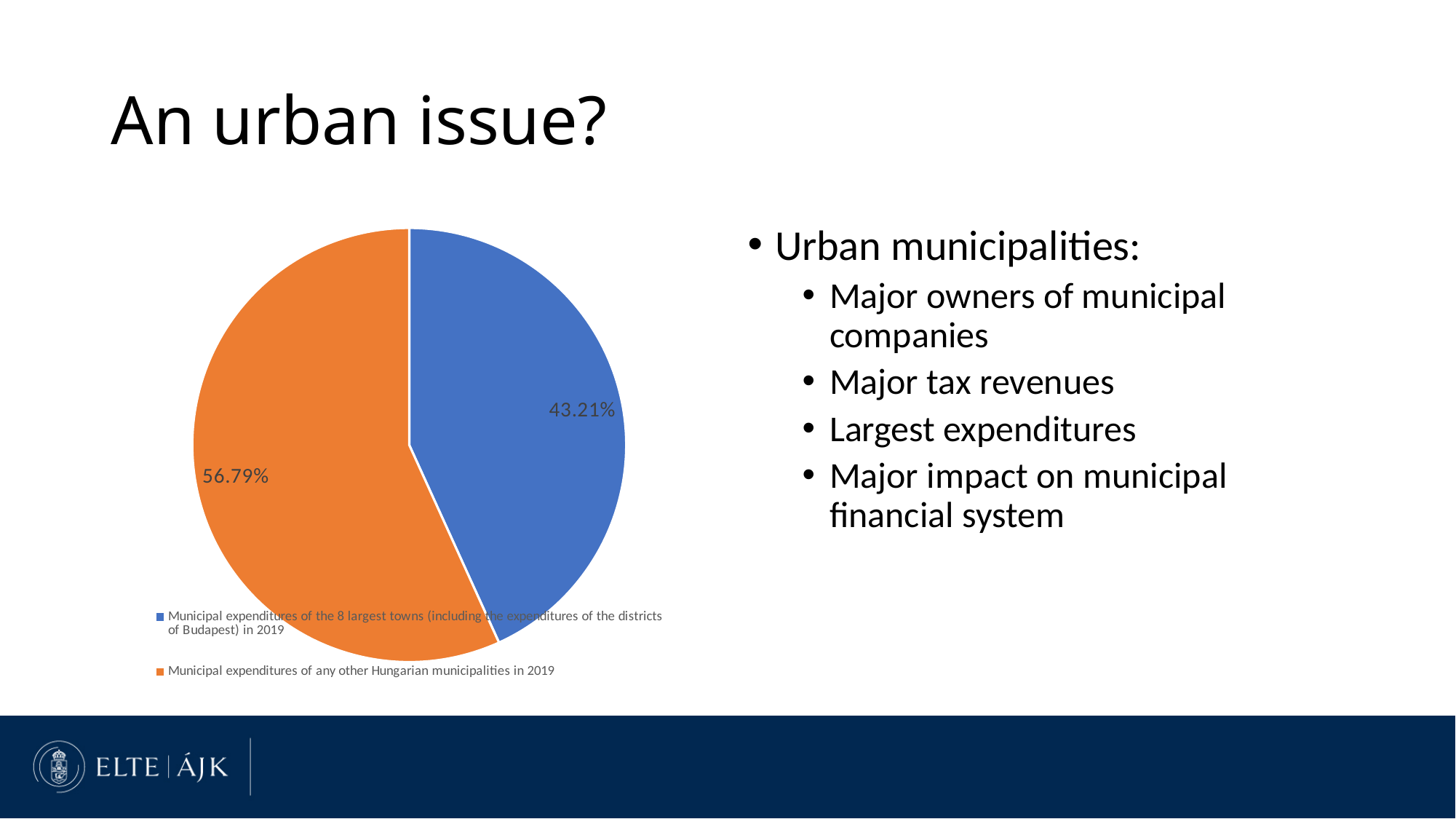
Which slice of the pie is the largest? Municipal expenditures of any other Hungarian municipalities in 2019 How many entries does the legend list? 2 What colour is the slice for municipal expenditures of any other Hungarian municipalities in 2019? orange Which slice of the pie is the smallest? Municipal expenditures of the 8 largest towns (including the expenditures of the districts of Budapest) in 2019 What colour is the slice for municipal expenditures of the 8 largest towns in 2019? blue Which is larger: the share for the 8 largest towns or the share for any other Hungarian municipalities? Any other Hungarian municipalities What share of the pie is labelled for municipal expenditures of any other Hungarian municipalities in 2019? 56.79% What kind of chart is shown on the slide? pie chart What share of the pie is labelled for municipal expenditures of the 8 largest towns (including the expenditures of the districts of Budapest) in 2019? 43.21% What is the difference in percentage points between the two slices of the pie? 13.58 Is the share for the 8 largest towns greater or less than 50%? less How many slices does the pie chart have? 2